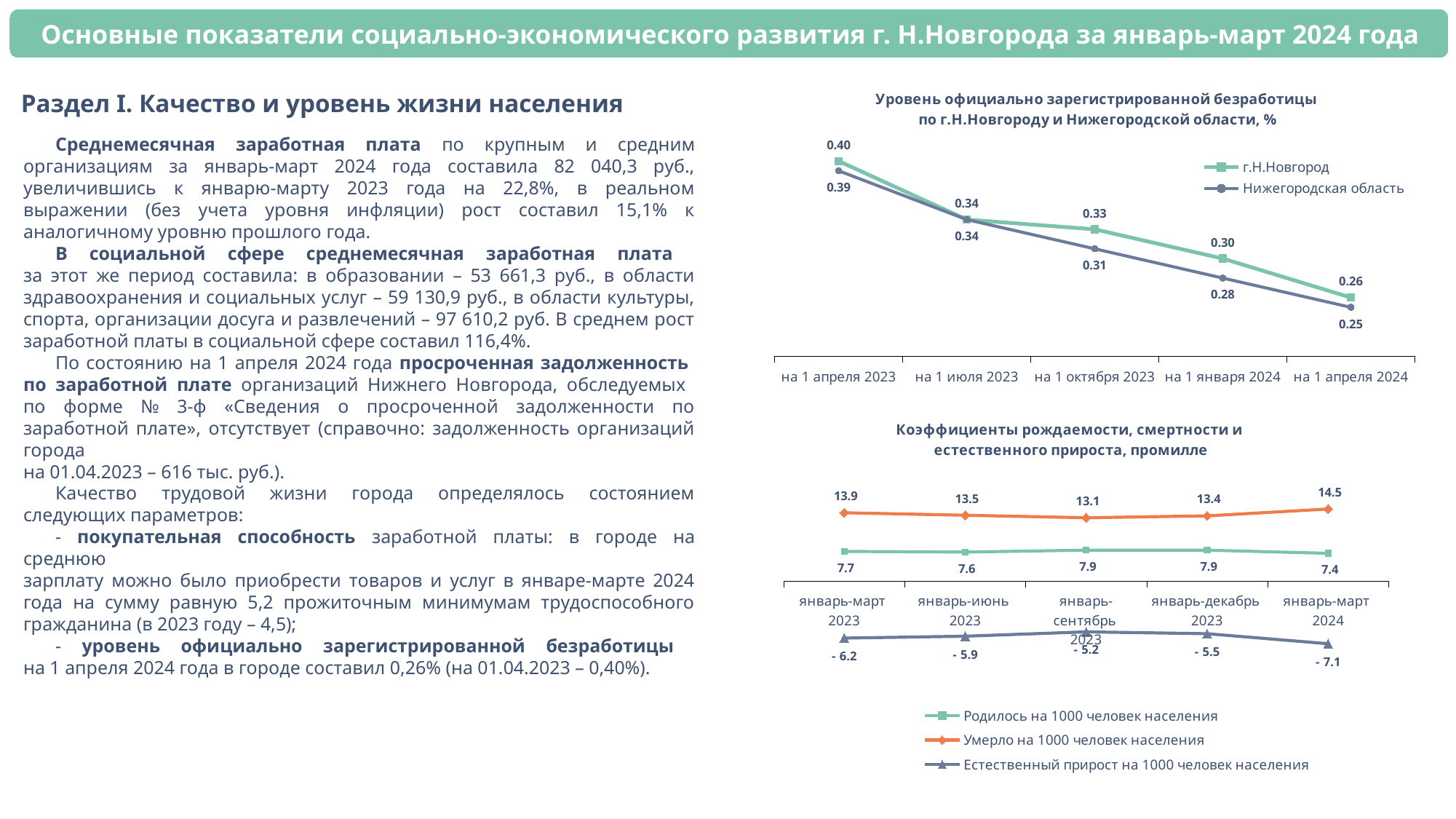
In the chart 'Коэффициенты рождаемости, смертности и естественного прироста, промилле', what is the value of 'Умерло на 1000 человек населения' for январь-март 2024? 14.5 What kind of chart is 'Коэффициенты рождаемости, смертности и естественного прироста, промилле'? line chart In the chart 'Коэффициенты рождаемости, смертности и естественного прироста, промилле', which is larger for январь-июнь 2023: 'Родилось на 1000 человек населения' or 'Умерло на 1000 человек населения'? Умерло на 1000 человек населения In the chart 'Уровень официально зарегистрированной безработицы по г.Н.Новгороду и Нижегородской области, %', what is the value for Нижегородская область на 1 октября 2023? 0.31 In the chart 'Уровень официально зарегистрированной безработицы по г.Н.Новгороду и Нижегородской области, %', how many series does the legend list? 2 In the chart 'Уровень официально зарегистрированной безработицы по г.Н.Новгороду и Нижегородской области, %', do the values for Нижегородская область rise or fall from left to right? fall In the chart 'Коэффициенты рождаемости, смертности и естественного прироста, промилле', how many periods are shown on the x axis? 5 In the chart 'Коэффициенты рождаемости, смертности и естественного прироста, промилле', for which period is 'Родилось на 1000 человек населения' lowest? январь-март 2024 In the chart 'Уровень официально зарегистрированной безработицы по г.Н.Новгороду и Нижегородской области, %', what is the difference between the г.Н.Новгород values на 1 апреля 2023 and на 1 апреля 2024? 0.14 In the chart 'Коэффициенты рождаемости, смертности и естественного прироста, промилле', what is the value of 'Естественный прирост на 1000 человек населения' for январь-сентябрь 2023? - 5.2 In the chart 'Уровень официально зарегистрированной безработицы по г.Н.Новгороду и Нижегородской области, %', at which date is the value for г.Н.Новгород highest? на 1 апреля 2023 In the chart 'Уровень официально зарегистрированной безработицы по г.Н.Новгороду и Нижегородской области, %', what is the value for г.Н.Новгород на 1 апреля 2024? 0.26